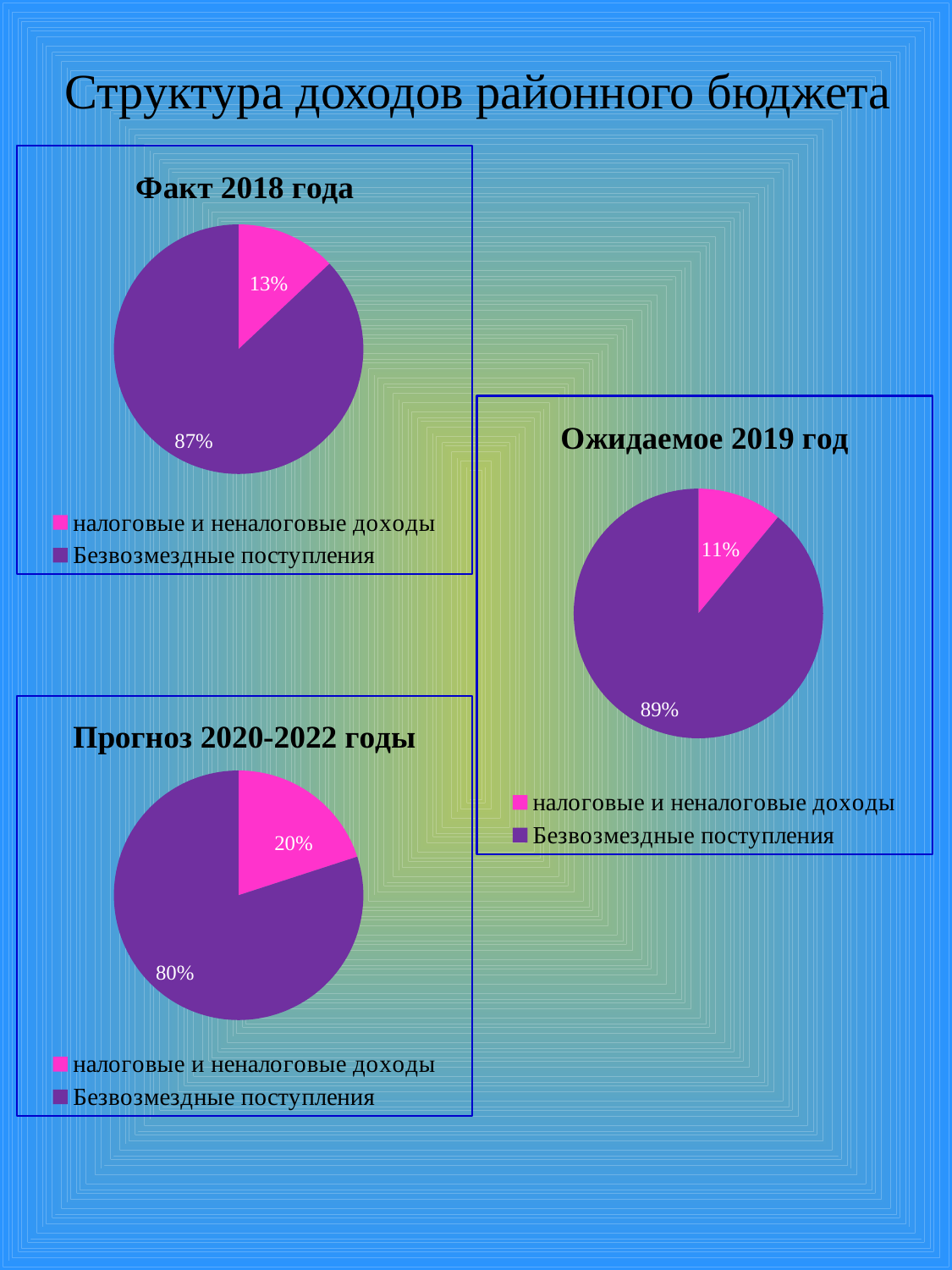
In the "Ожидаемое 2019 год" chart, which category is the largest? Безвозмездные поступления In the "Ожидаемое 2019 год" chart, what is the value for "Безвозмездные поступления"? 89% In the "Факт 2018 года" chart, what is the difference between "Безвозмездные поступления" and "налоговые и неналоговые доходы"? 74% In the "Факт 2018 года" chart, what share does "Безвозмездные поступления" have? 87% In the "Факт 2018 года" chart, what share does "налоговые и неналоговые доходы" have? 13% In the "Прогноз 2020-2022 годы" chart, which category is the smallest? налоговые и неналоговые доходы What kind of chart is the "Факт 2018 года" chart? Pie chart How many slices does the "Ожидаемое 2019 год" pie chart have? 2 In the "Прогноз 2020-2022 годы" chart, what share does "налоговые и неналоговые доходы" have? 20% In the "Ожидаемое 2019 год" chart, what is the value for "налоговые и неналоговые доходы"? 11% How many entries does the legend of the "Прогноз 2020-2022 годы" chart list? 2 In the "Прогноз 2020-2022 годы" chart, what is the value for "Безвозмездные поступления"? 80%